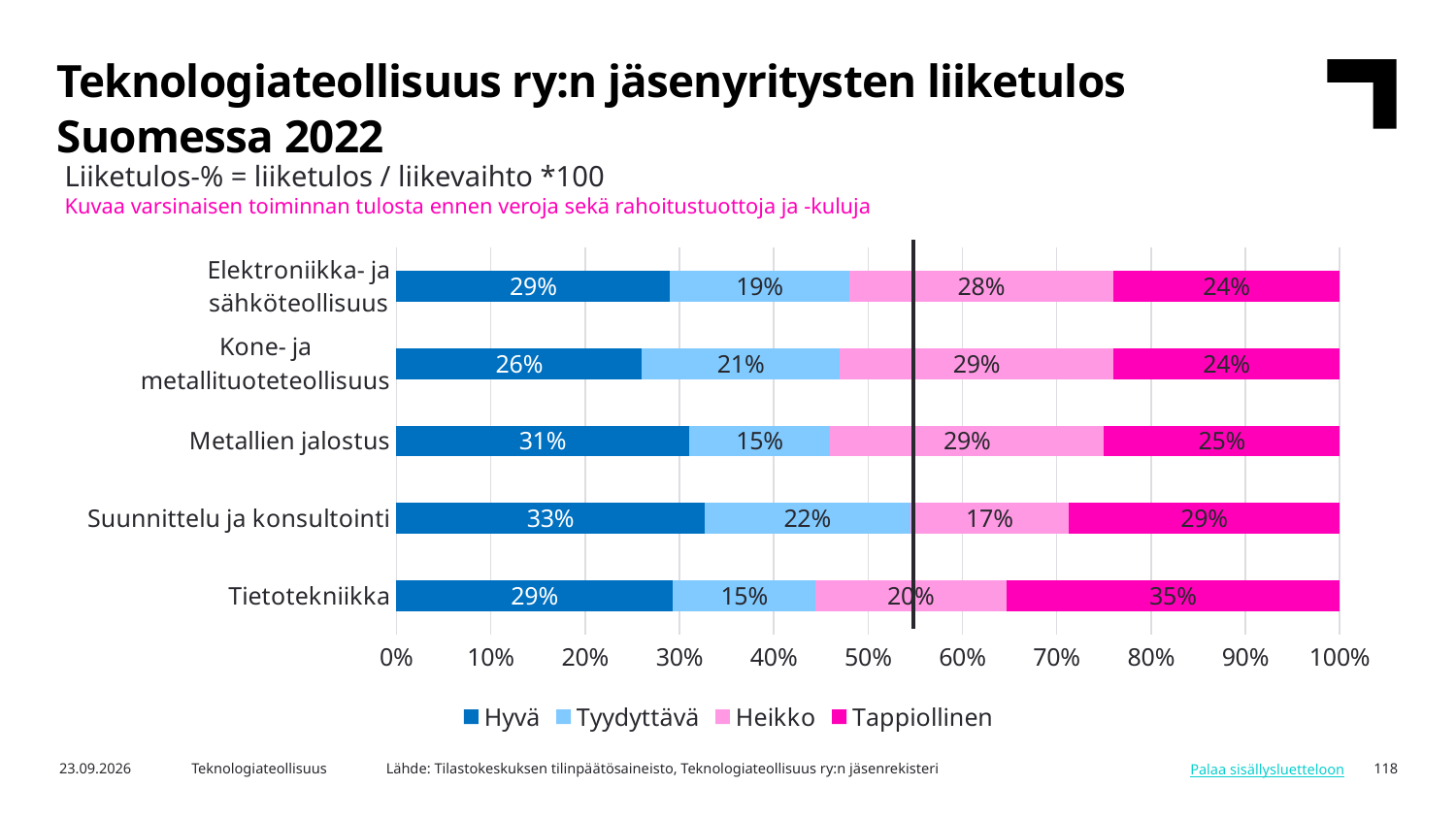
What is the combined share of Hyvä and Tyydyttävä for Metallien jalostus? 46% How many series does the legend list? 4 Which category has the highest Tappiollinen share? Tietotekniikka Which is larger: the Heikko share for Metallien jalostus or for Suunnittelu ja konsultointi? Metallien jalostus What is the Hyvä share for Suunnittelu ja konsultointi? 33% What is the Tyydyttävä share for Kone- ja metallituoteteollisuus? 21% Which category has the lowest Hyvä share? Kone- ja metallituoteteollisuus How many categories are shown on the chart? 5 What is the Heikko share for Elektroniikka- ja sähköteollisuus? 28% What is the difference between the Tappiollinen share for Tietotekniikka and for Suunnittelu ja konsultointi? 6 percentage points What is the Tappiollinen share for Tietotekniikka? 35% What kind of chart is shown on the slide? Stacked bar chart